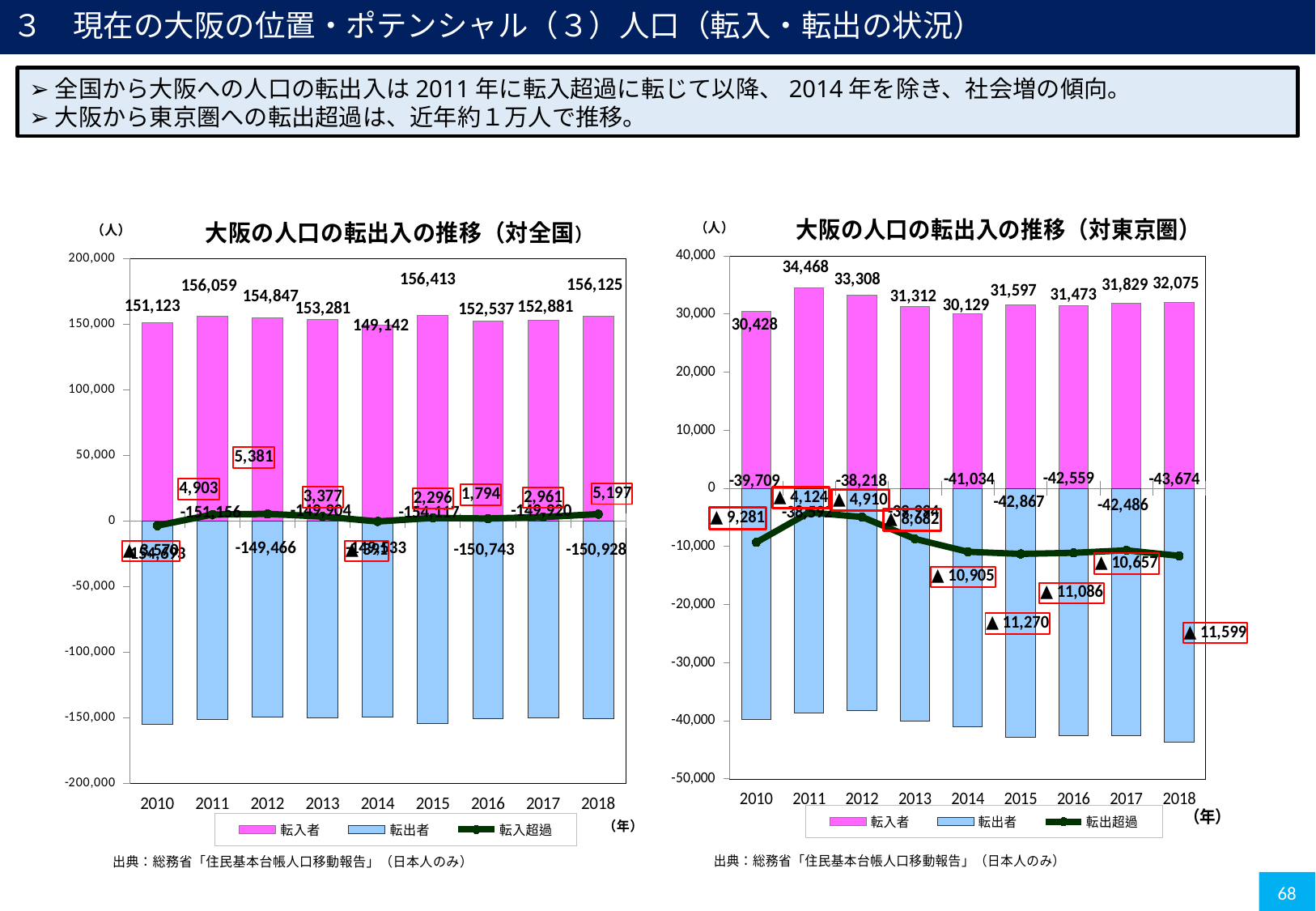
In the chart titled 大阪の人口の転出入の推移（対東京圏）, is the 転入者 value for 2011 larger or smaller than the value for 2014? larger What kind of chart is 大阪の人口の転出入の推移（対東京圏）? Bar chart with a line In the chart titled 大阪の人口の転出入の推移（対東京圏）, what is the 転出超過 value for 2018? ▲ 11,599 In the chart titled 大阪の人口の転出入の推移（対全国）, what is the 転出者 value for 2016? -150,743 In the chart titled 大阪の人口の転出入の推移（対全国）, which year has the lowest 転入者 value? 2014 In the chart titled 大阪の人口の転出入の推移（対東京圏）, which year has the highest 転入者 value? 2011 In the chart titled 大阪の人口の転出入の推移（対全国）, what is the difference between the 転入者 values for 2011 and 2010? 4,936 In the chart titled 大阪の人口の転出入の推移（対東京圏）, what is the 転出者 value for 2015? -42,867 In the chart titled 大阪の人口の転出入の推移（対全国）, how many series does the legend list? 3 In the chart titled 大阪の人口の転出入の推移（対全国）, what is the 転入超過 value for 2012? 5,381 In the chart titled 大阪の人口の転出入の推移（対東京圏）, how many years are shown on the x axis? 9 In the chart titled 大阪の人口の転出入の推移（対全国）, what is the 転入者 value for 2015? 156,413